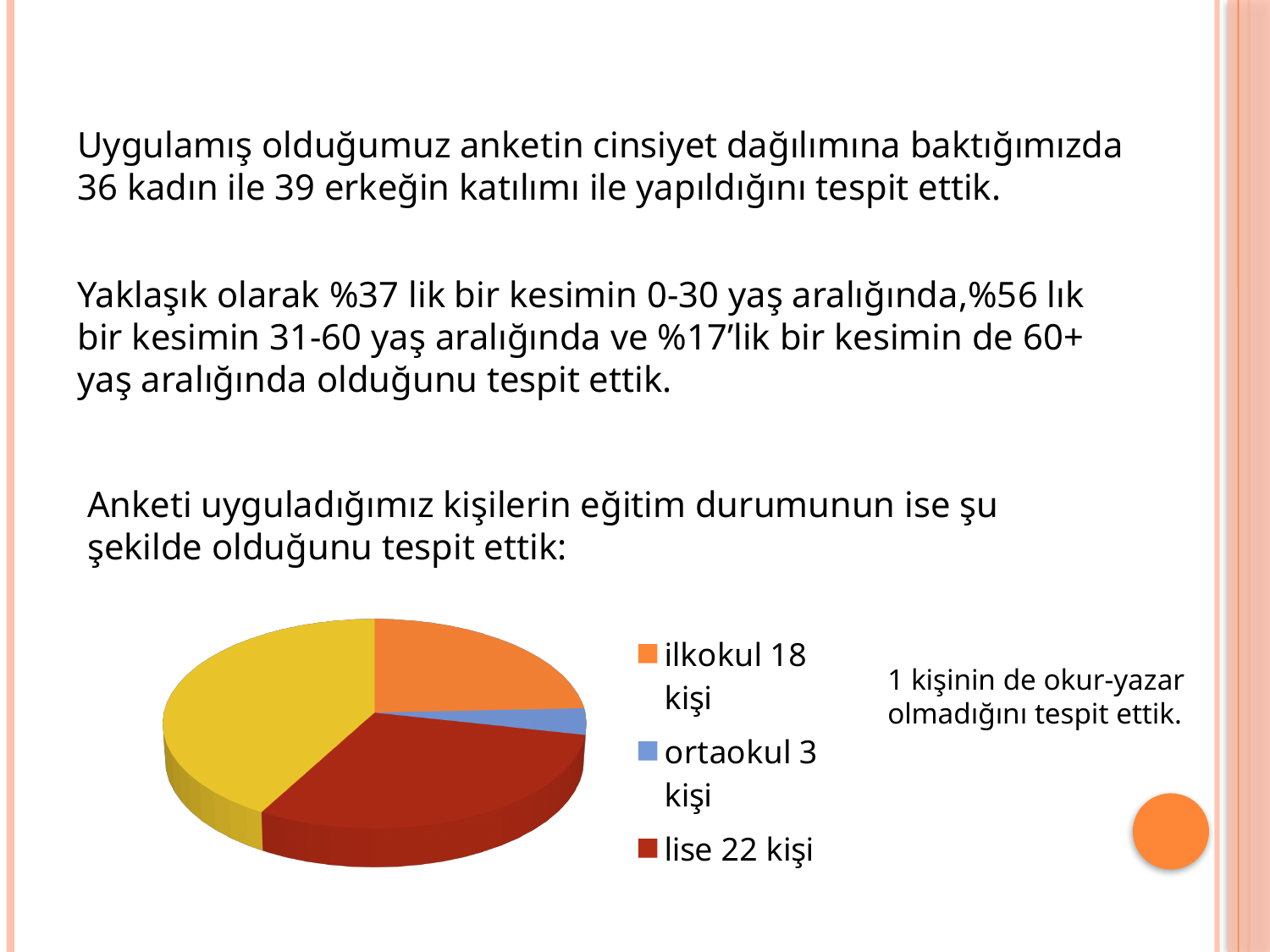
What colour is the lise slice in the pie chart? red How many slices does the pie chart have? 4 Which has more people, ilkokul or lise? lise How many more people are in lise than in ilkokul? 4 How many entries does the legend of the pie chart list? 3 Which has more people, ortaokul or ilkokul? ilkokul Which category in the legend has the fewest people? ortaokul How many people are in the lise category according to the legend? 22 kişi How many more people are in ilkokul than in ortaokul? 15 How many people are in the ilkokul category according to the legend? 18 kişi What kind of chart is shown on the slide? pie chart How many people are in the ortaokul category according to the legend? 3 kişi